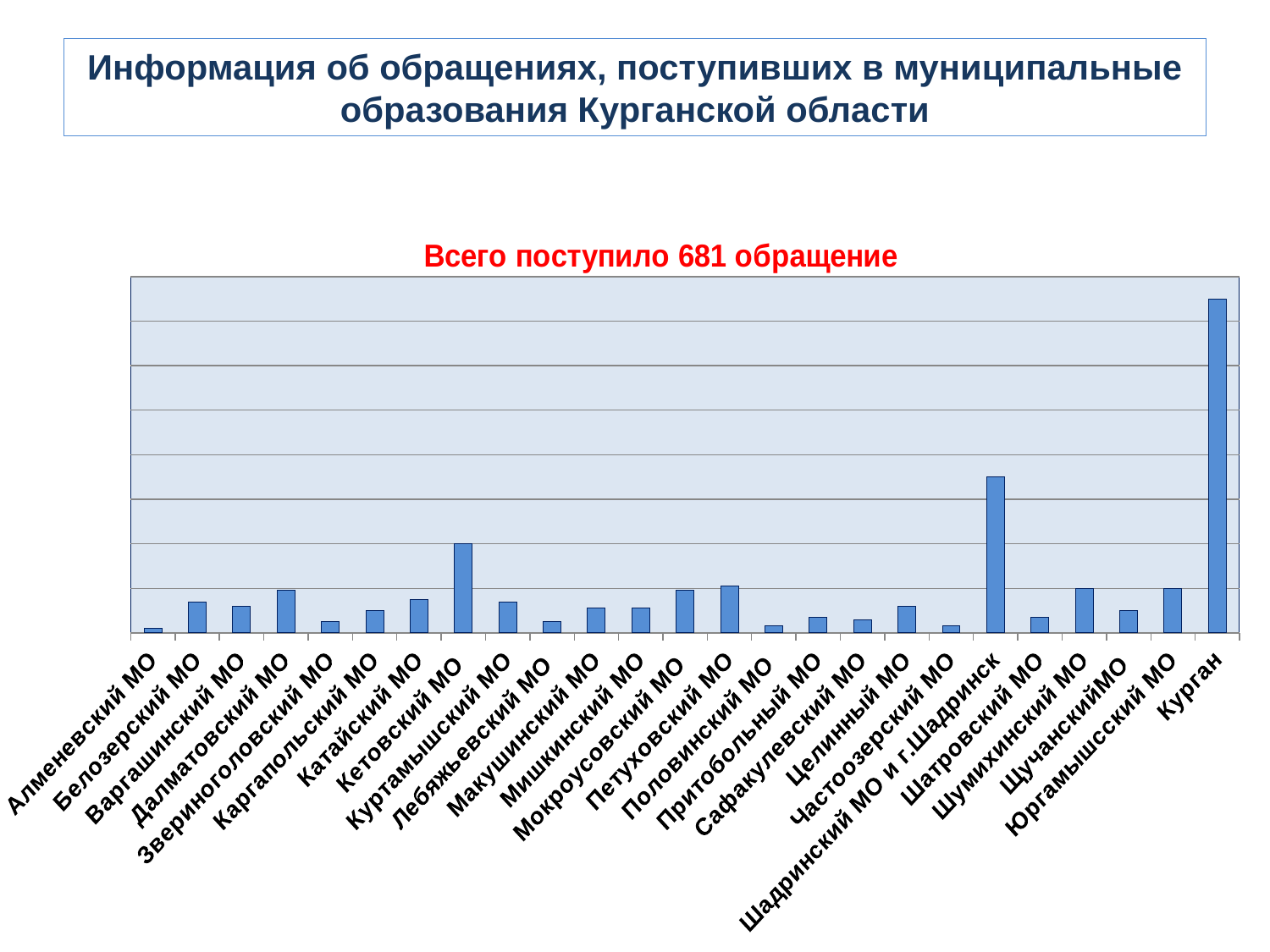
Which has the larger value, Кетовский МО or Далматовский МО? Кетовский МО What is the title shown in red above the chart? Всего поступило 681 обращение What kind of chart is shown on the slide? bar chart Which municipality has the lowest bar in the chart? Алменевский МО How many municipalities (categories) are shown on the x axis of the chart? 25 Which has the larger value, Курган or Шадринский МО и г.Шадринск? Курган Which municipality has the second highest bar in the chart? Шадринский МО и г.Шадринск Which municipality has the highest bar in the chart? Курган Which has the larger value, Алменевский МО or Белозерский МО? Белозерский МО According to the chart title, how many appeals were received in total? 681